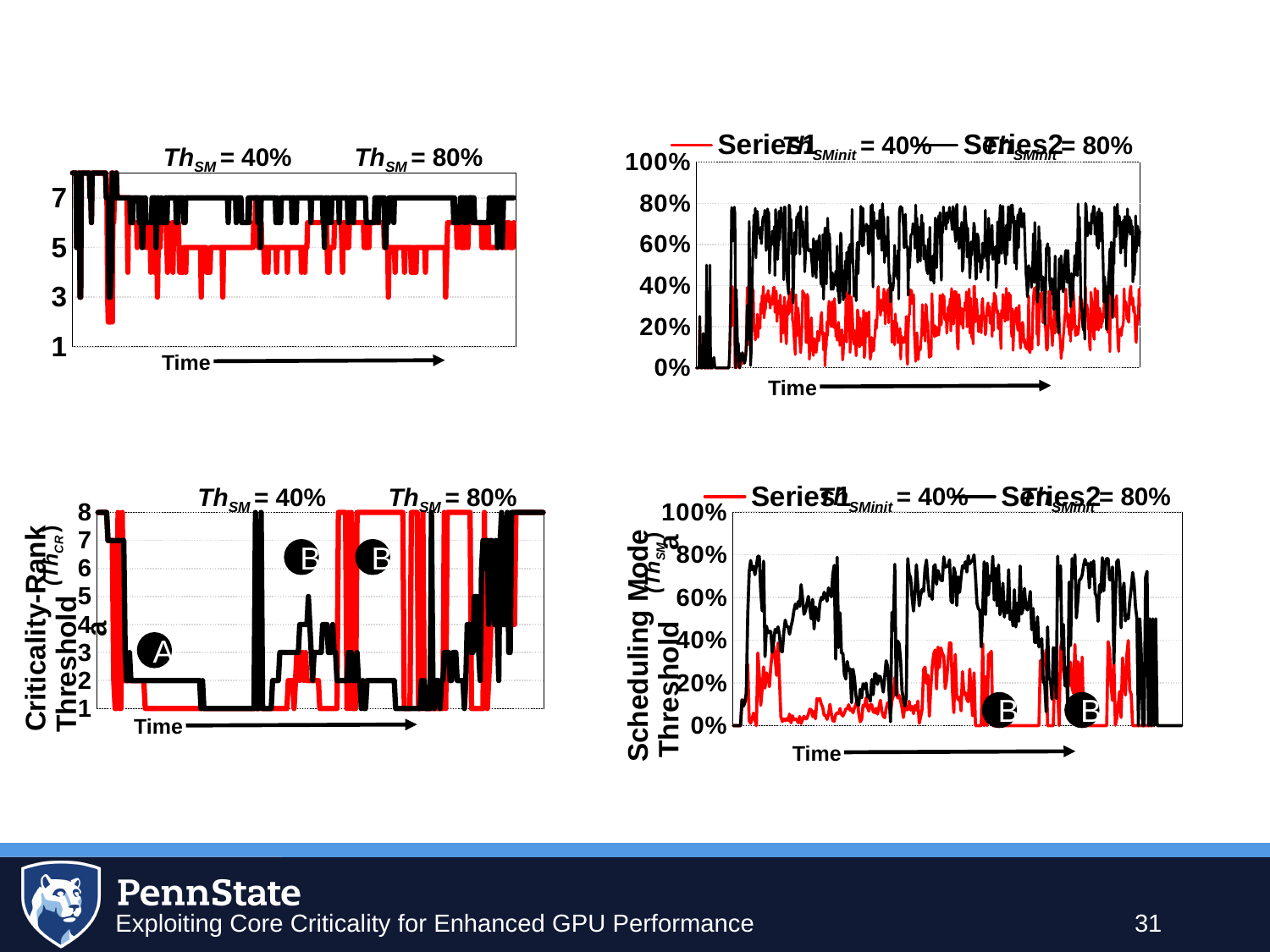
What kind of chart is the bottom-right chart on the slide? line chart How many charts are shown on the slide? 4 In the bottom-left chart, what value does the red line start at on the left of the time axis? 8 How many series does the legend of the top-left chart list? 2 What kind of chart is the top-left chart on the slide? line chart What is the y-axis label of the bottom-left chart? Criticality-Rank Threshold (Th_CR) How many series does the legend of the bottom-left chart list? 2 In the top-right chart, which line generally has higher values over time, the red line or the black line? the black line In the bottom-left chart, is the starting value of the black line greater or less than 4? greater In the top-right chart, is the highest value reached by the red line greater or less than 60%? less In the bottom-right chart, is the highest value reached by the red line greater or less than 60%? less